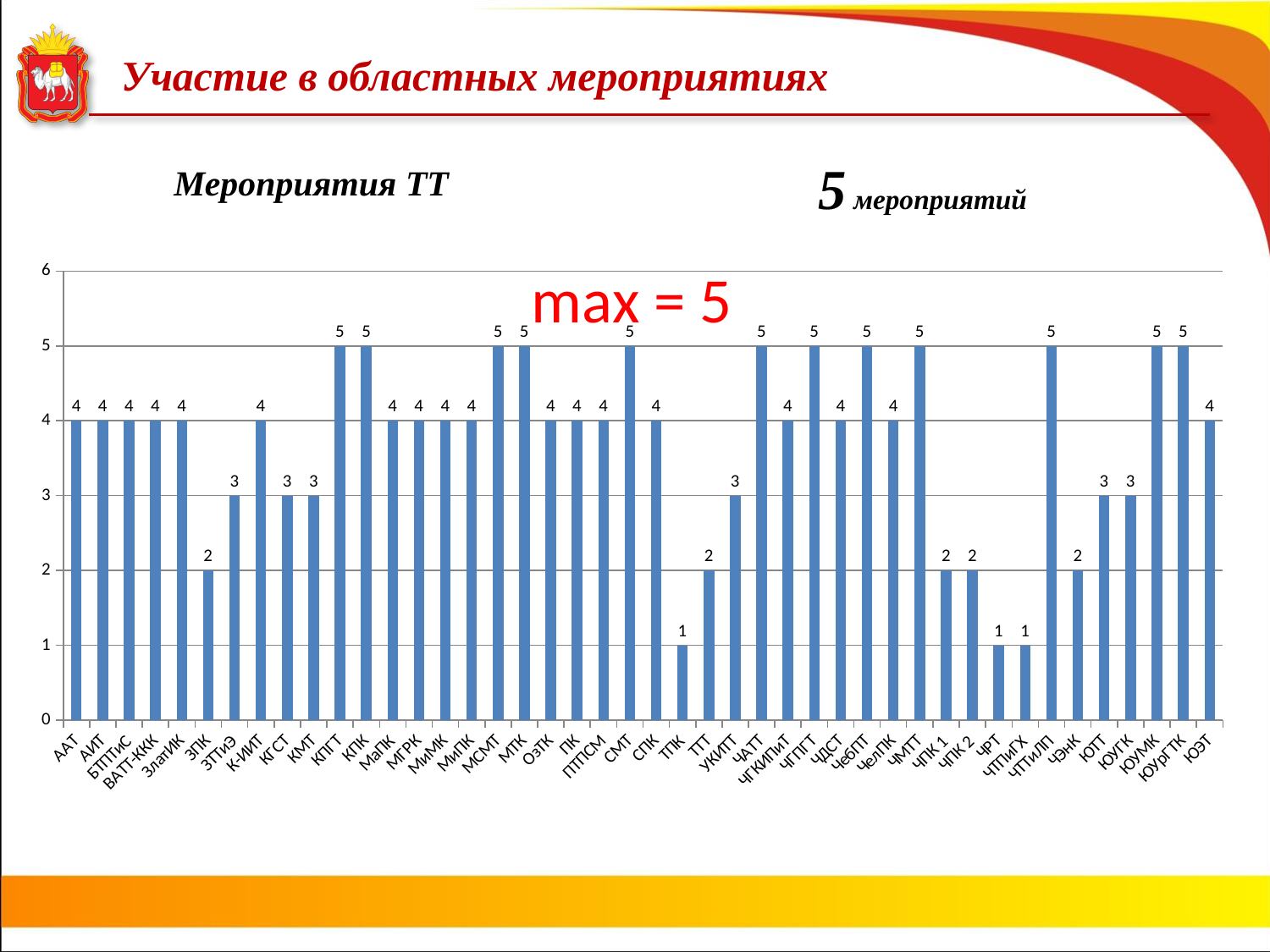
What is the value for ЗПК? 2 How many categories have a value of 1? 3 What is the value for ТПК? 1 What kind of chart is shown on the slide? bar chart What is the lowest value shown on the chart? 1 What is the value for КПГТ? 5 What is the value for ЧЭнК? 2 What is the title of the chart? Мероприятия ТТ Which is larger, the value for ЗТТиЭ or the value for К-ИИТ? К-ИИТ What is the highest value shown on the chart? 5 What is the difference between the values for КПГТ and ЗПК? 3 What is the value for ЮЭТ? 4